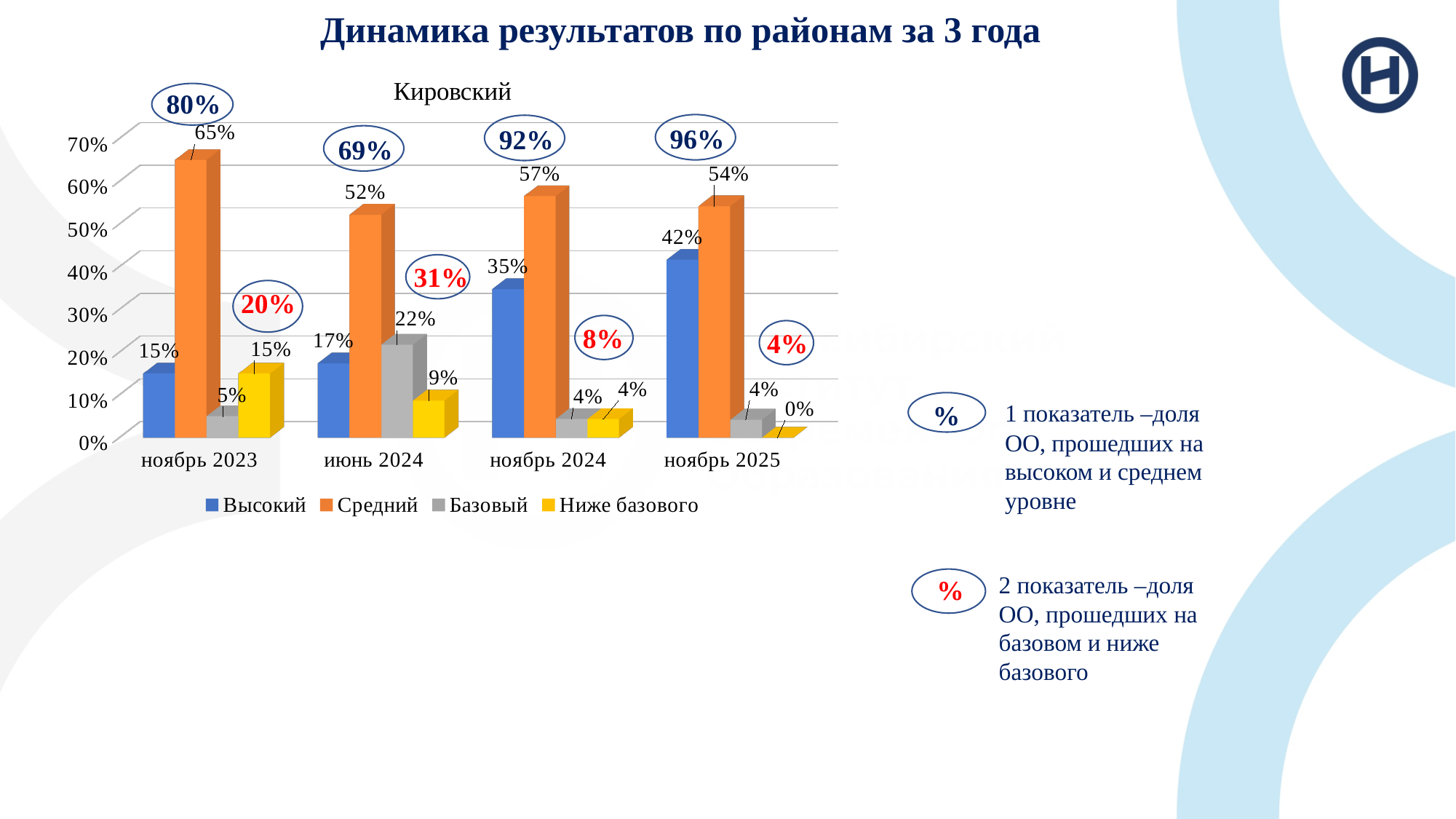
What is the difference between the Средний values for ноябрь 2023 and ноябрь 2025? 11% How many periods are shown on the x axis? 4 What is the value for Средний in ноябрь 2023? 65% Does the Высокий series rise or fall from ноябрь 2023 to ноябрь 2025? Rise What is the value for Высокий in ноябрь 2025? 42% What is the value for Базовый in июнь 2024? 22% Which is larger in ноябрь 2024: Высокий or Средний? Средний In which period is the Средний series lowest? июнь 2024 What kind of chart is shown? Bar chart In which period is the Высокий series highest? ноябрь 2025 How many series does the legend list? 4 What is the value for Ниже базового in ноябрь 2025? 0%